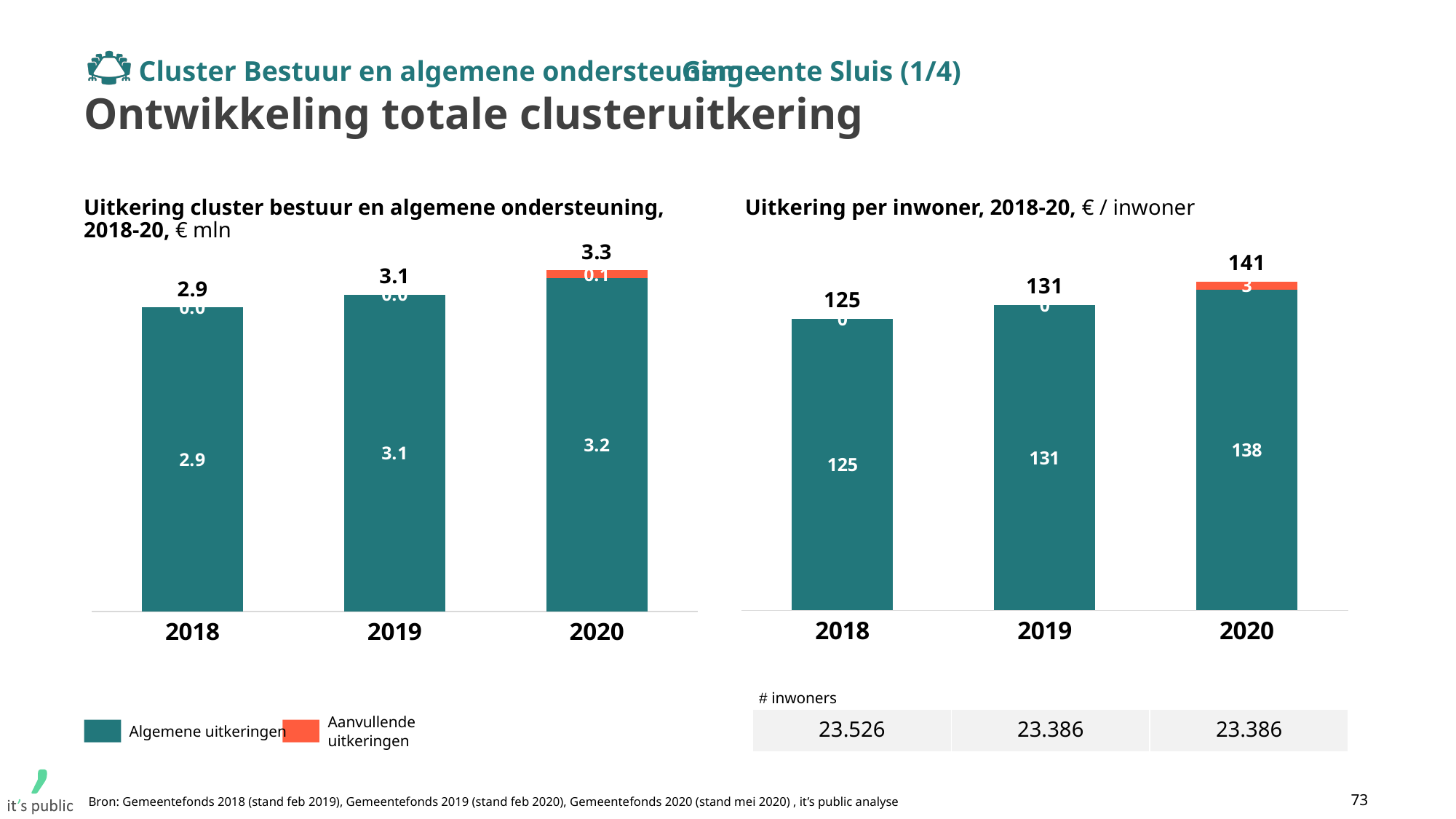
In the right chart (Uitkering per inwoner), what is the difference between the totals for 2019 and 2018? 6 In the right chart (Uitkering per inwoner), what is the value of Algemene uitkeringen for 2020? 138 In the left chart (Uitkering cluster bestuur en algemene ondersteuning), what is the value of Algemene uitkeringen for 2020? 3.2 What kind of chart is the right chart (Uitkering per inwoner)? stacked bar chart In the left chart (Uitkering cluster bestuur en algemene ondersteuning), what is the total of the stacked bar for 2020? 3.3 In the left chart (Uitkering cluster bestuur en algemene ondersteuning), what is the value of Aanvullende uitkeringen for 2020? 0.1 In the right chart (Uitkering per inwoner), do the totals rise or fall from 2018 to 2020? rise How many series does the legend list for the left chart? 2 In the right chart (Uitkering per inwoner), what is the total for 2020? 141 In the left chart (Uitkering cluster bestuur en algemene ondersteuning), which year has the lowest total? 2018 In the right chart (Uitkering per inwoner), what is the value of Aanvullende uitkeringen for 2020? 3 In the left chart (Uitkering cluster bestuur en algemene ondersteuning), what is the difference between the totals for 2020 and 2018? 0.4